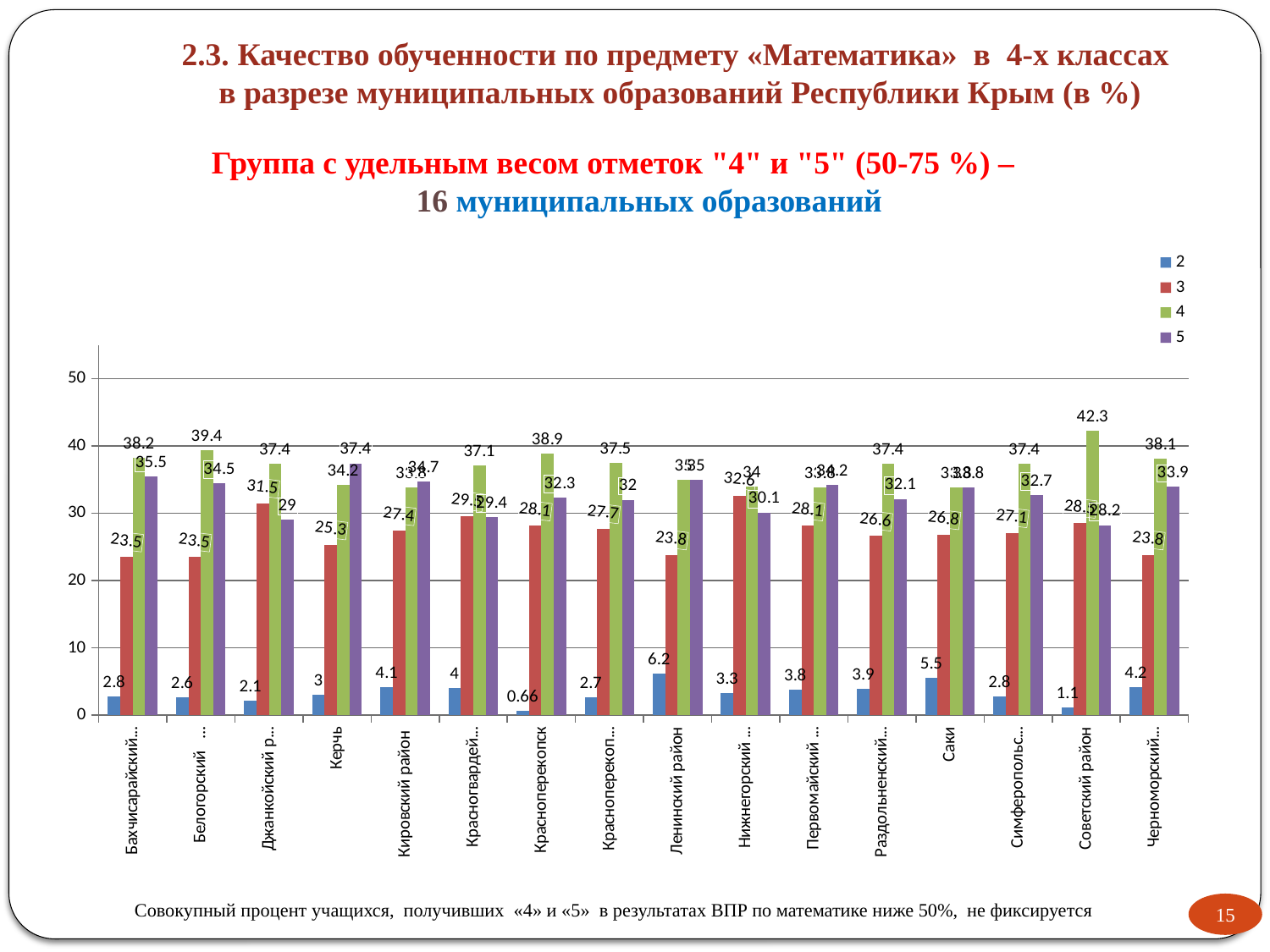
Which category has the highest value in series "4"? Советский район What is the difference between the series "2" values for Ленинский район and Саки? 0.7 Which category has the lowest value in series "2"? Красноперекопск What is the value of series "5" for Керчь? 37.4 What type of chart is shown on the slide? bar chart What is the value of series "2" for Ленинский район? 6.2 What is the value of series "4" for Советский район? 42.3 What is the value of series "2" for Красноперекопск? 0.66 For Керчь, which series has the larger value: "4" or "5"? 5 How many series does the legend list? 4 What is the value of series "3" for Кировский район? 27.4 Is the value of series "4" for Советский район greater or less than 40? greater